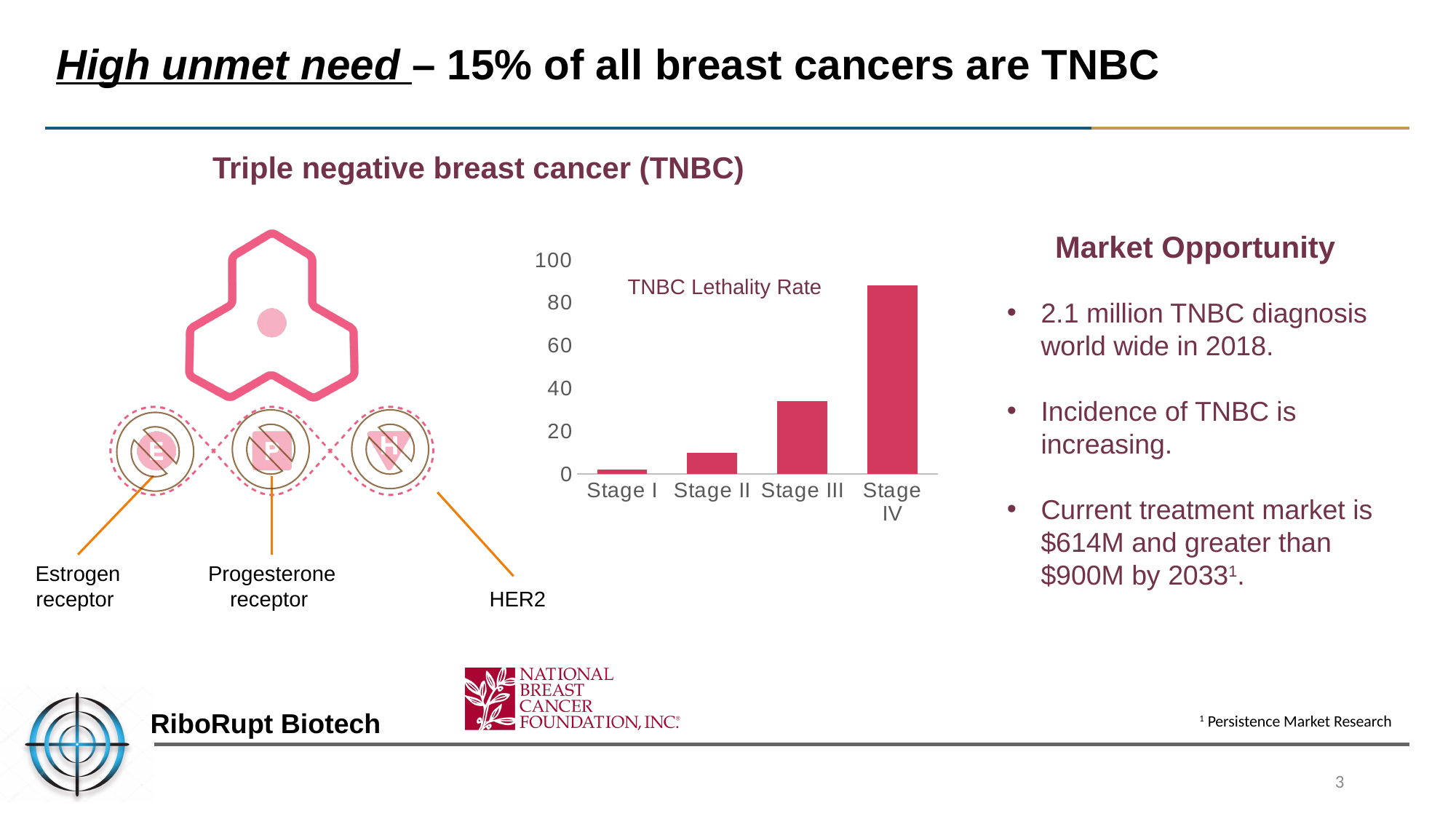
Do the lethality rates rise or fall from Stage I to Stage IV? rise What is the title of the chart on the slide? TNBC Lethality Rate How many stages are shown on the x axis of the TNBC Lethality Rate chart? 4 Which has a higher lethality rate, Stage II or Stage III? Stage III What is the maximum value shown on the y axis of the TNBC Lethality Rate chart? 100 Which stage has the lowest lethality rate in the chart? Stage I Is the lethality rate for Stage III greater or less than 40? less What kind of chart is the TNBC Lethality Rate chart? bar chart Which stage has the highest lethality rate in the chart? Stage IV Is the lethality rate for Stage II greater or less than 20? less Is the lethality rate for Stage IV greater or less than 80? greater